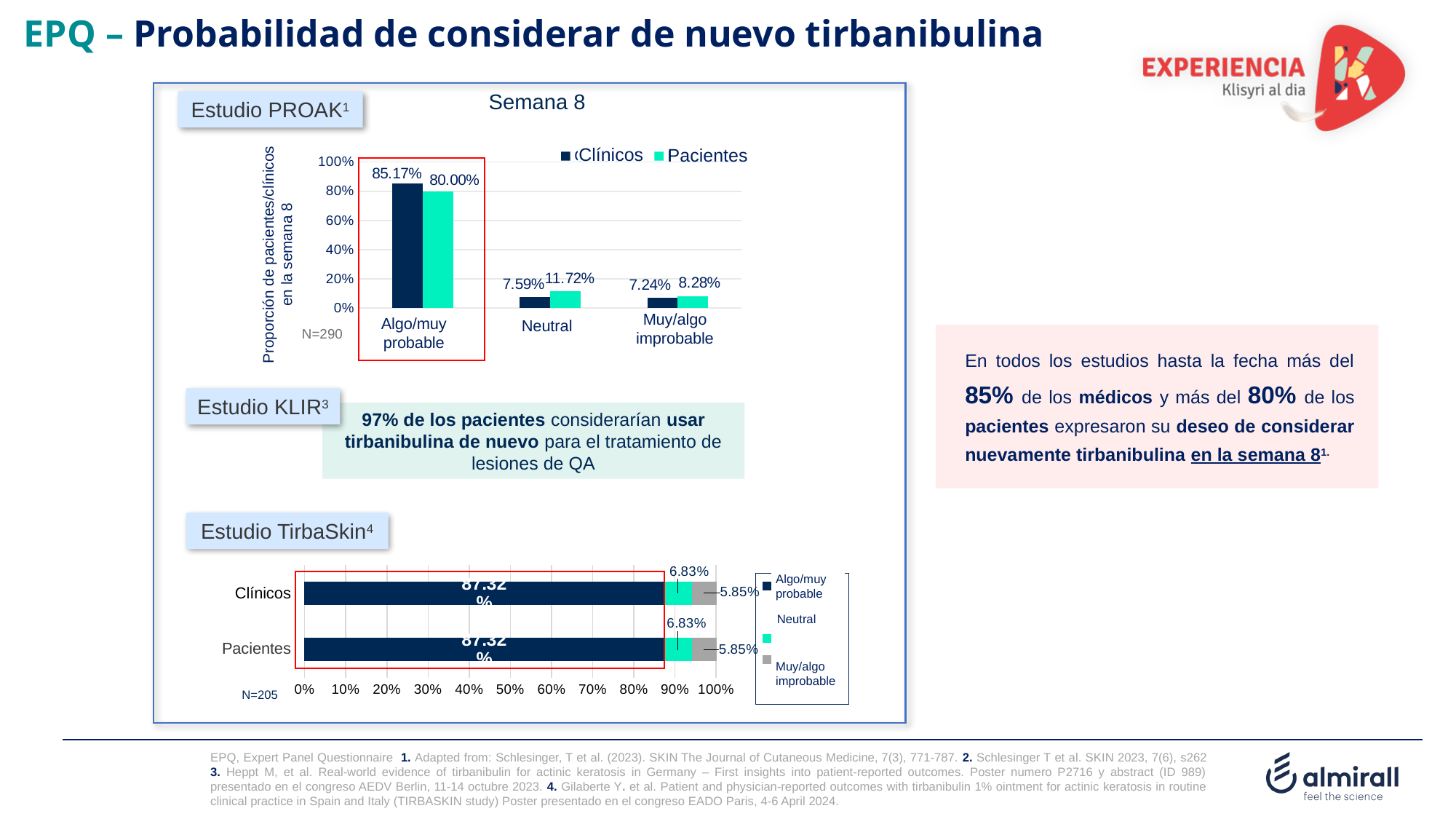
In the top chart (Estudio PROAK, Semana 8), how many series does the legend list? 2 In the top chart (Estudio PROAK, Semana 8), what is the value for Pacientes in the Muy/algo improbable category? 8.28% In the bottom chart (Estudio TirbaSkin), what is the total of the stacked bar for Clínicos? 100.00% In the bottom chart (Estudio TirbaSkin), what is the Neutral value for Clínicos? 6.83% What kind of chart is the bottom chart (Estudio TirbaSkin)? Stacked horizontal bar chart In the bottom chart (Estudio TirbaSkin), what is the Algo/muy probable value for Pacientes? 87.32% In the top chart (Estudio PROAK, Semana 8), what is the value for Pacientes in the Neutral category? 11.72% In the top chart (Estudio PROAK, Semana 8), what is the value for Clínicos in the Algo/muy probable category? 85.17% In the top chart (Estudio PROAK, Semana 8), what is the difference between the Clínicos and Pacientes values in the Algo/muy probable category? 5.17 percentage points In the top chart (Estudio PROAK, Semana 8), how many categories are shown on the x axis? 3 In the top chart (Estudio PROAK, Semana 8), which category has the highest value for Clínicos? Algo/muy probable In the top chart (Estudio PROAK, Semana 8), which is larger in the Neutral category: Clínicos or Pacientes? Pacientes